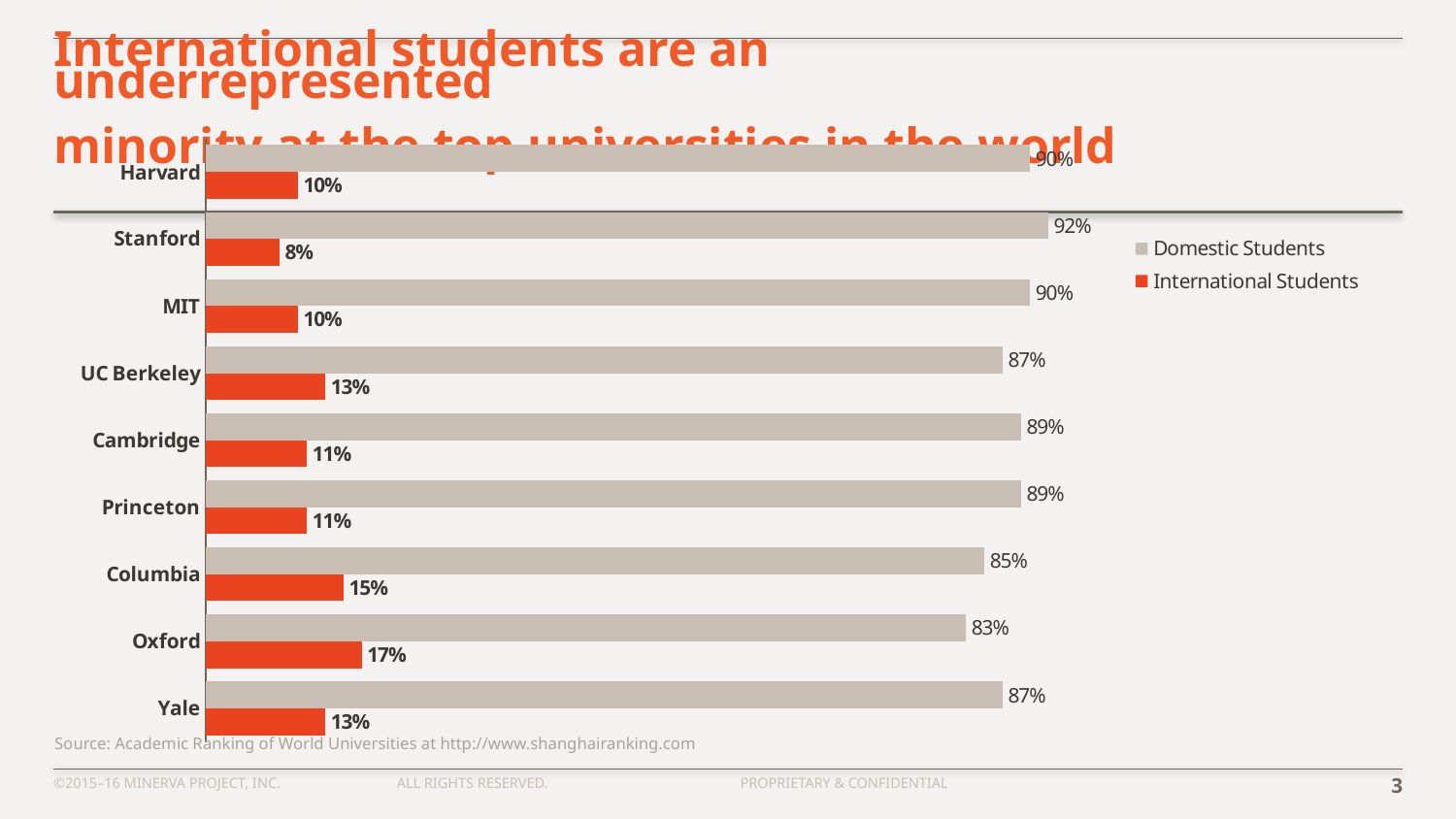
Which has a larger share of international students, Columbia or Cambridge? Columbia Which university has the lowest share of international students? Stanford What is the value for Domestic Students at Stanford? 92% What type of chart is shown on the slide? Bar chart What is the difference between the international student percentages at Oxford and Stanford? 9% Which university has the highest share of international students? Oxford What percentage of Columbia's students are domestic students? 85% What percentage of students at Oxford are international students? 17% How many universities are shown in the chart? 9 Which university has the lowest share of domestic students? Oxford How many series does the legend list? 2 Which colour represents International Students in the chart? Orange